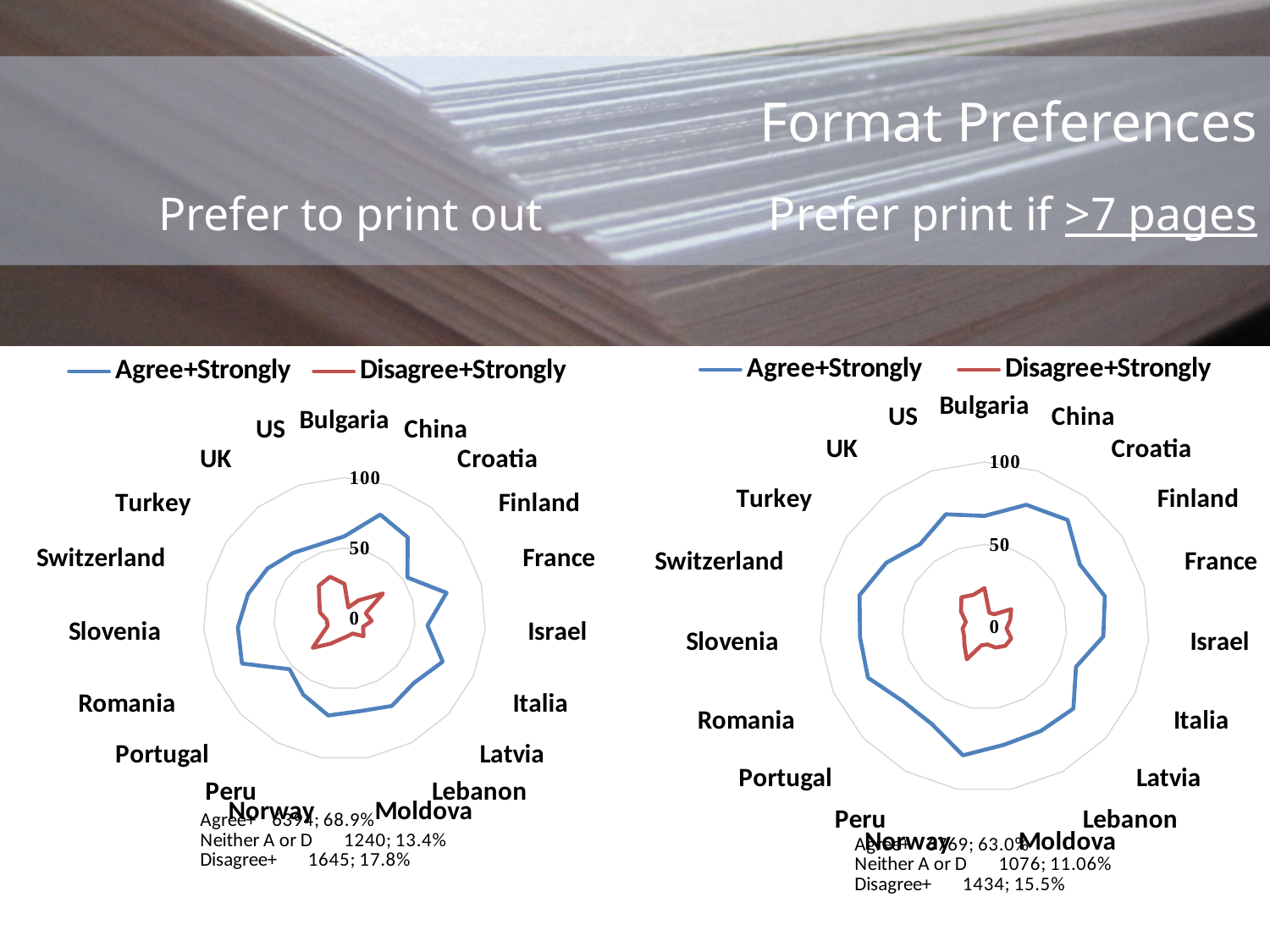
What is the highest tick value shown on the radial axis of the 'Prefer print if >7 pages' chart on the right? 100 What kind of chart is the 'Prefer to print out' chart on the left? Radar chart In the 'Prefer to print out' chart on the left, which colour is used for the Disagree+Strongly series? Red How many series does the legend of the 'Prefer print if >7 pages' chart on the right list? 2 In the 'Prefer print if >7 pages' chart on the right, is the Disagree+Strongly value for Israel greater or less than 50? less In the 'Prefer to print out' chart on the left, is the Agree+Strongly value for France greater or less than 50? greater What are the two series named in the legend of the 'Prefer to print out' chart on the left? Agree+Strongly and Disagree+Strongly In the 'Prefer to print out' chart on the left, which series has the larger value for Israel, Agree+Strongly or Disagree+Strongly? Agree+Strongly How many countries are plotted around the 'Prefer to print out' chart on the left? 19 In the 'Prefer to print out' chart on the left, is the Disagree+Strongly value for Finland greater or less than 50? less In the 'Prefer print if >7 pages' chart on the right, which series has the larger value for Bulgaria, Agree+Strongly or Disagree+Strongly? Agree+Strongly